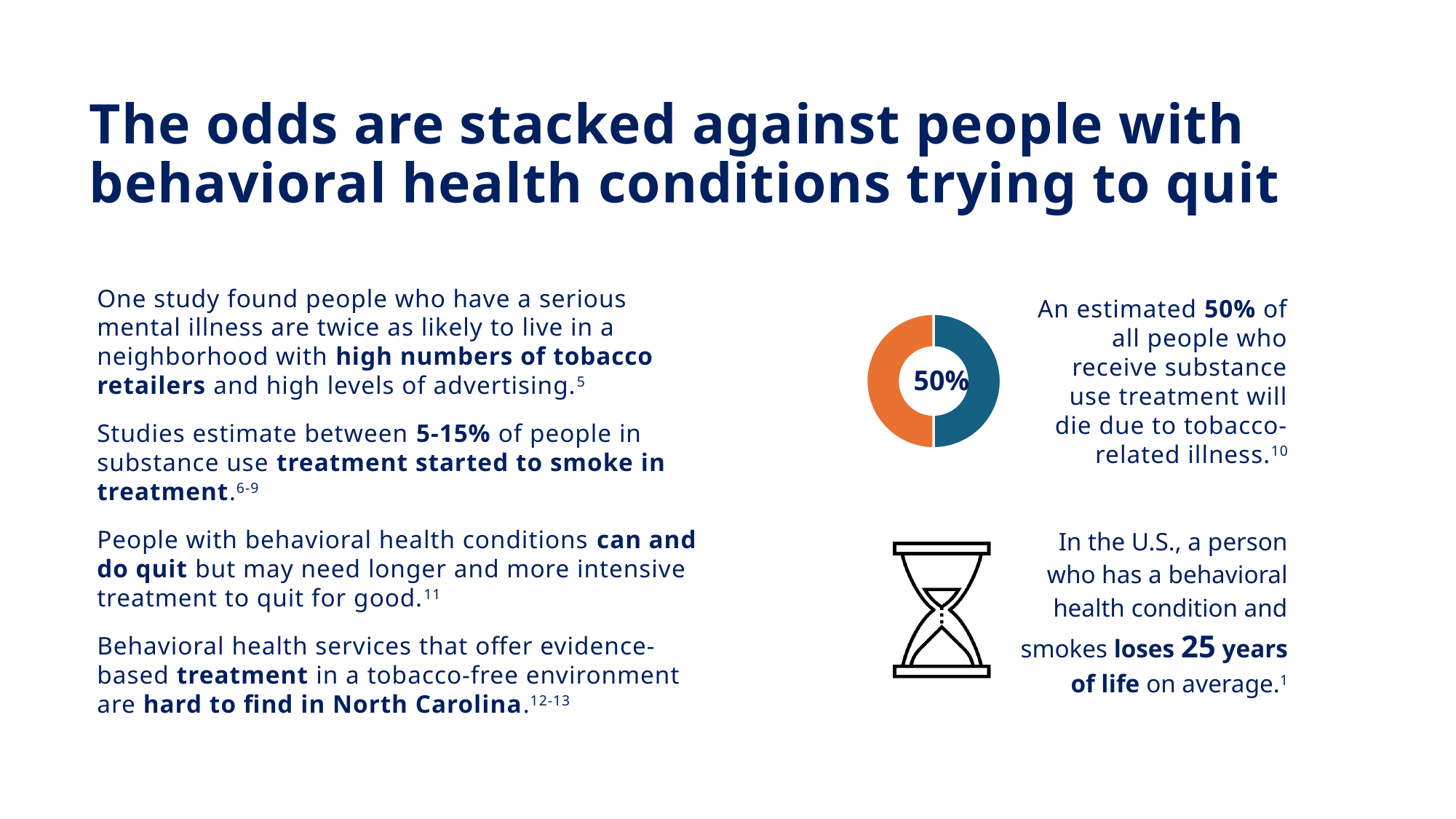
Does the doughnut chart display a legend? No Is the blue slice of the doughnut chart larger or smaller than the orange slice, or are they equal? equal What share of the doughnut chart does the blue slice represent? 50% What value is printed in the center of the doughnut chart? 50% What share of the doughnut chart does the orange slice represent? 50% How many slices does the doughnut chart have? 2 What two colours are used for the slices of the doughnut chart? orange and blue What kind of chart is shown next to the text about substance use treatment? doughnut chart